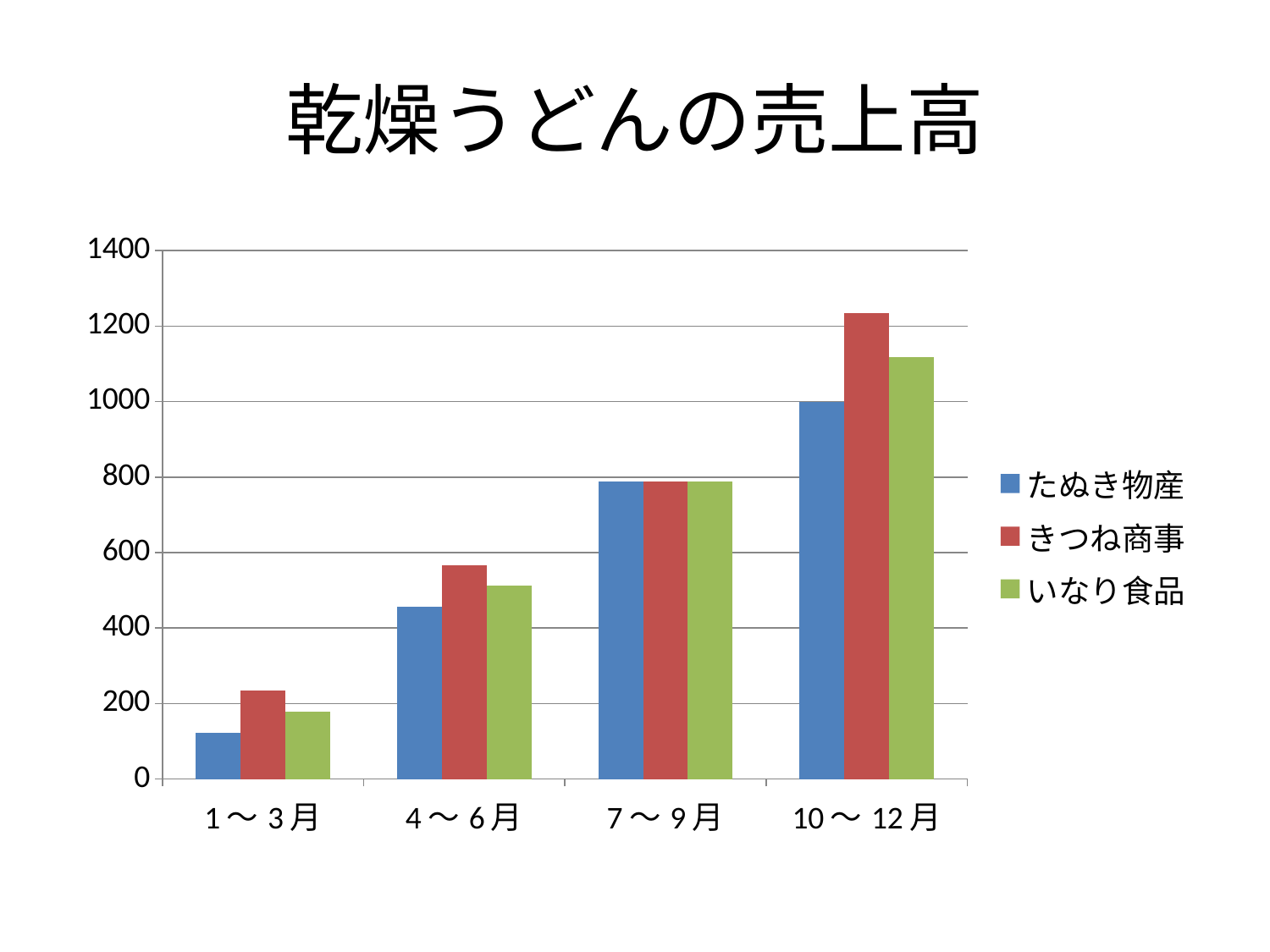
Which series is shown in red? きつね商事 Do the values for いなり食品 rise or fall from 1～3月 to 10～12月? rise Is the value for きつね商事 in 10～12月 greater or less than 1200? greater What is the title of the chart? 乾燥うどんの売上高 Which category has the lowest value for たぬき物産? 1～3月 Is the value for たぬき物産 in 1～3月 greater or less than 200? less How many categories are shown on the x axis? 4 Which series has the highest value in 10～12月? きつね商事 How many series does the legend list? 3 Which is larger in 4～6月, the value for きつね商事 or the value for たぬき物産? きつね商事 What kind of chart is shown on the slide? bar chart Which category has the highest value for きつね商事? 10～12月